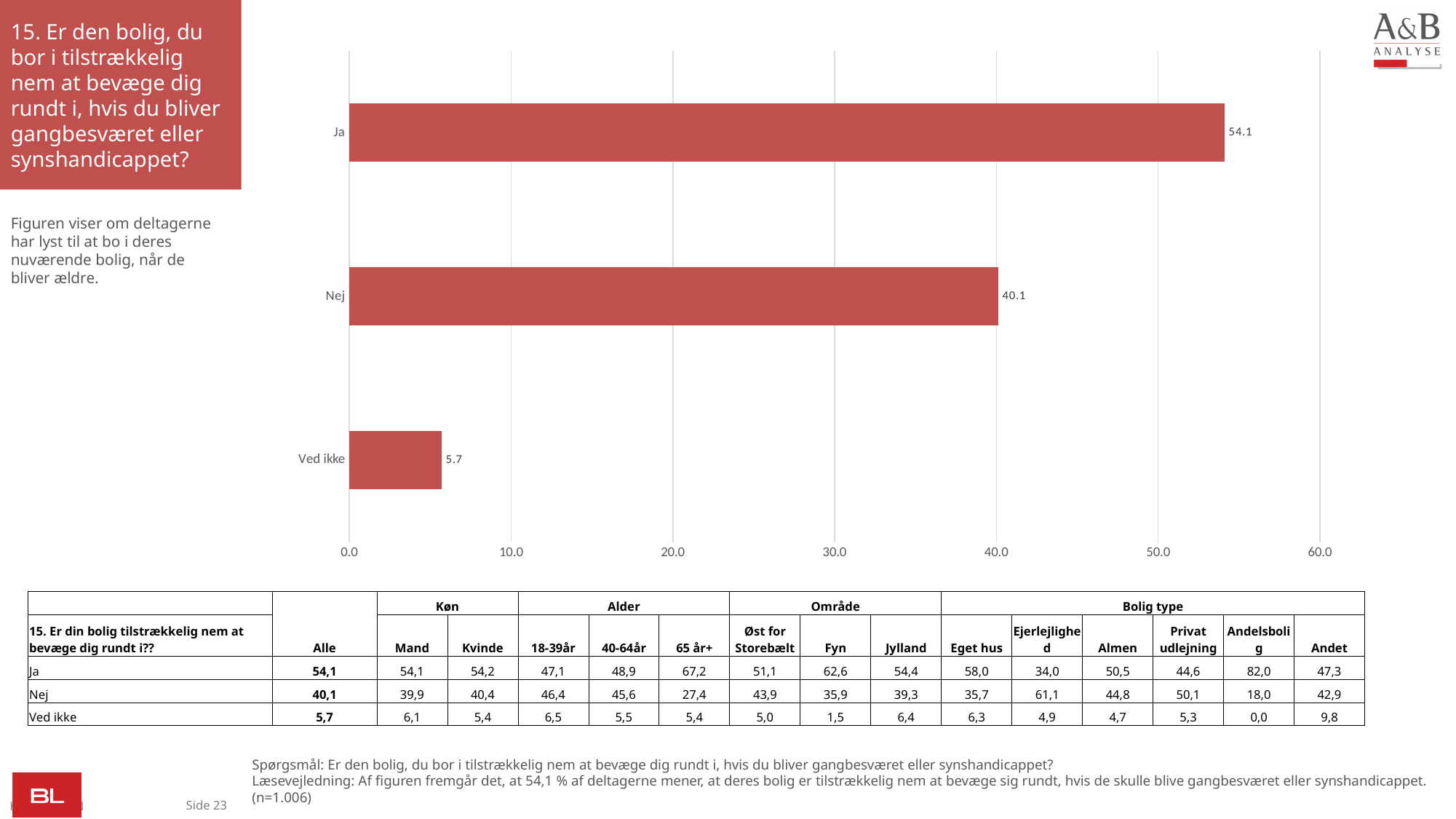
What is the difference between the values for "Nej" and "Ved ikke" in the bar chart? 34.4 Which is larger in the bar chart, the value for "Nej" or the value for "Ved ikke"? Nej What type of chart is shown on the slide? Bar chart What is the value shown for "Nej" in the bar chart? 40.1 Which category has the highest value in the bar chart? Ja What is the value shown for "Ved ikke" in the bar chart? 5.7 What is the difference between the values for "Ja" and "Nej" in the bar chart? 14.0 What is the maximum value shown on the horizontal axis of the bar chart? 60.0 Which category has the lowest value in the bar chart? Ved ikke Is the value for "Nej" in the bar chart greater or less than 30.0? greater What is the value shown for "Ja" in the bar chart? 54.1 How many categories are shown in the bar chart? 3